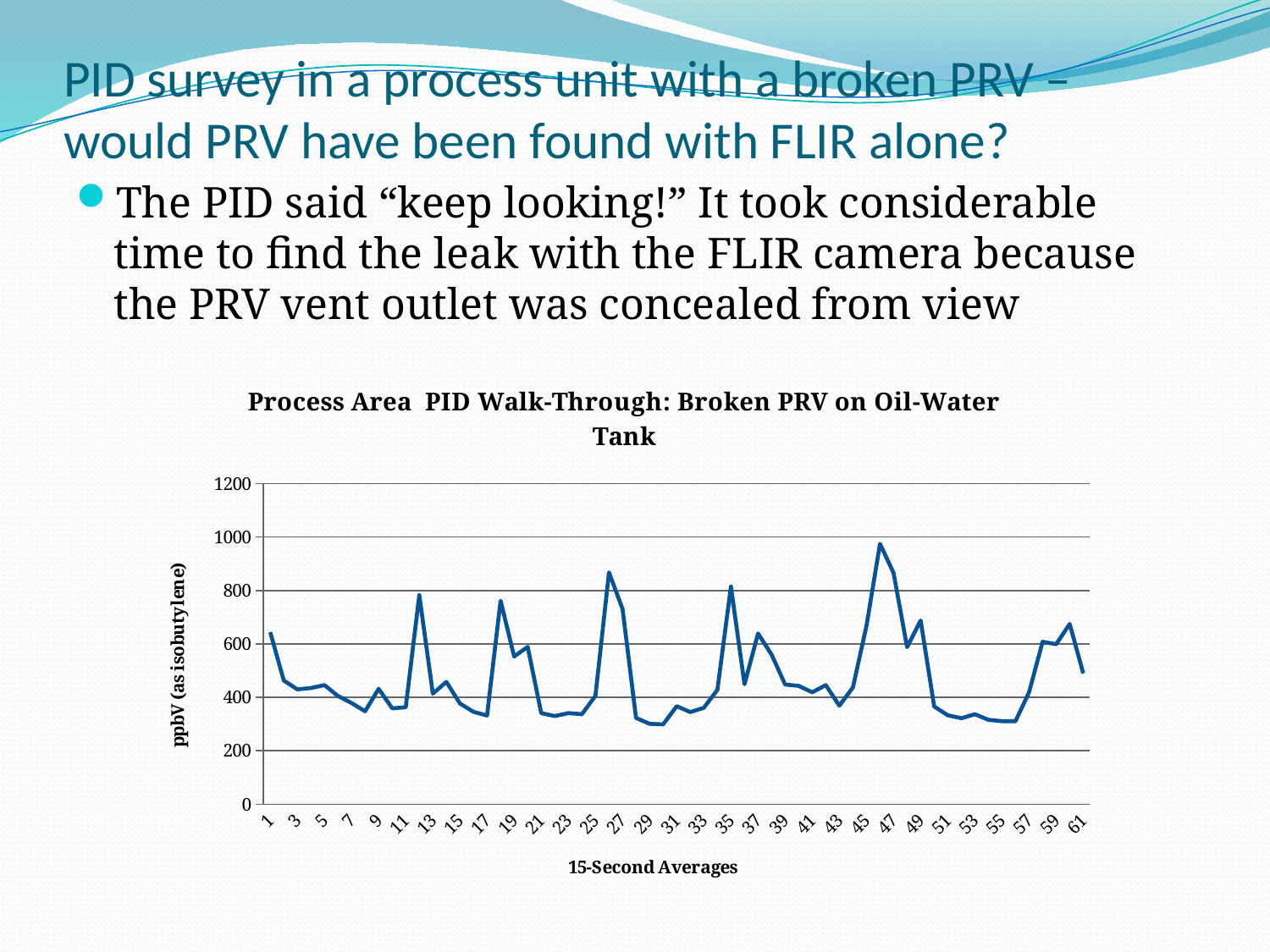
Is the highest peak on the line greater or less than 1000? less Is the highest peak on the line greater or less than 800? greater Is the value at x = 29 greater or less than 400? less What is the title of the chart? Process Area PID Walk-Through: Broken PRV on Oil-Water Tank What is the label on the vertical axis of the chart? ppbV (as isobutylene) What kind of chart is shown on the slide? line chart Does the line show a steady rise, a steady fall, or repeated spikes along the x axis? repeated spikes What is the highest value shown on the vertical axis? 1200